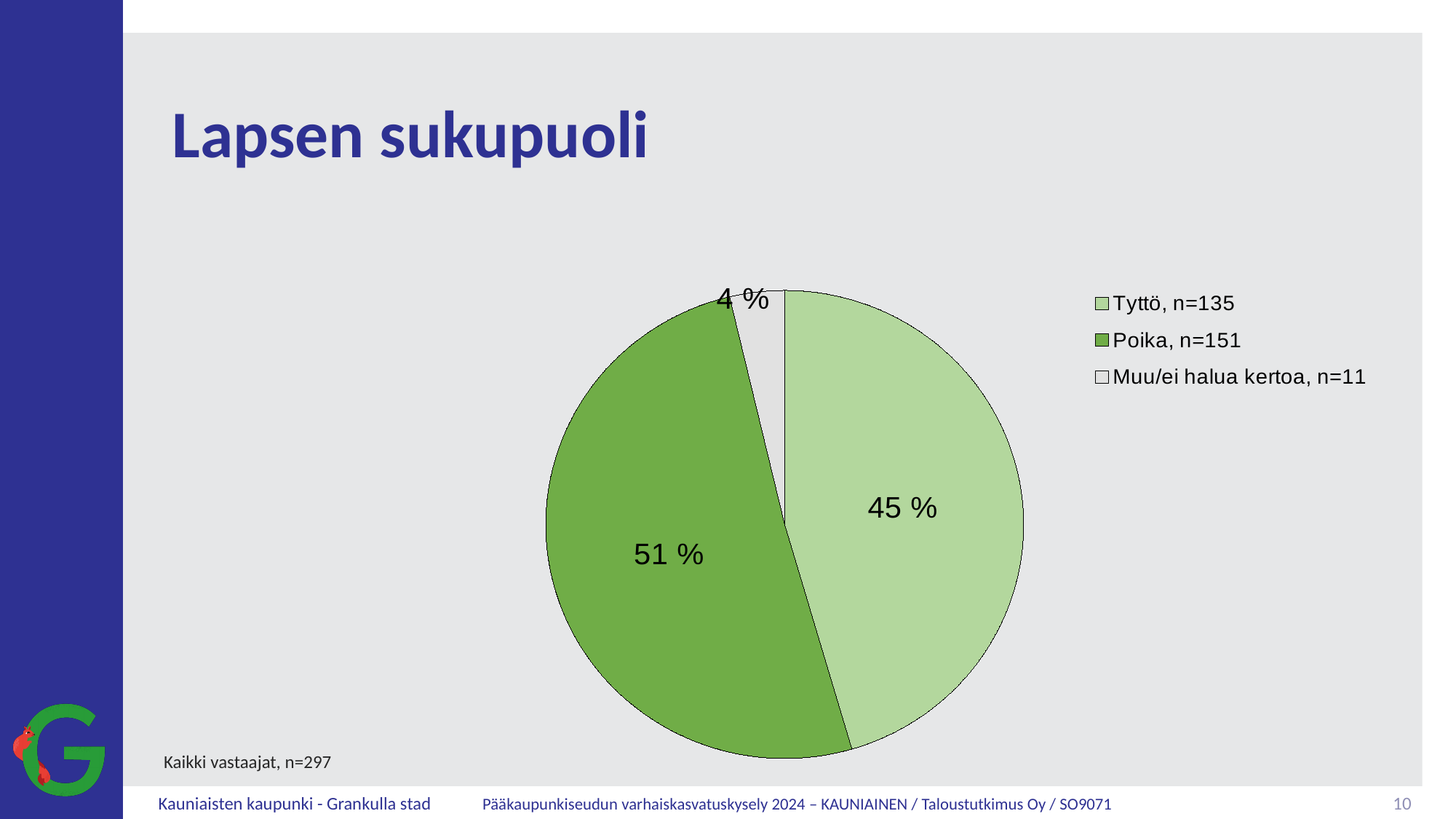
How many respondents are included in the chart according to the note below it? n=297 What share of the pie does Poika (n=151) have? 51 % What kind of chart is shown on the slide? pie chart What is the difference in percentage points between the Poika slice and the Tyttö slice? 6 percentage points What share of the pie does Muu/ei halua kertoa (n=11) have? 4 % What share of the pie does Tyttö (n=135) have? 45 % Which is larger, the Tyttö slice or the Muu/ei halua kertoa slice? Tyttö How many slices does the pie chart have? 3 Which slice of the pie is the largest? Poika, n=151 Which slice of the pie is the smallest? Muu/ei halua kertoa, n=11 Is the share for Tyttö greater or less than 50 %? less What is the title of the slide containing the pie chart? Lapsen sukupuoli